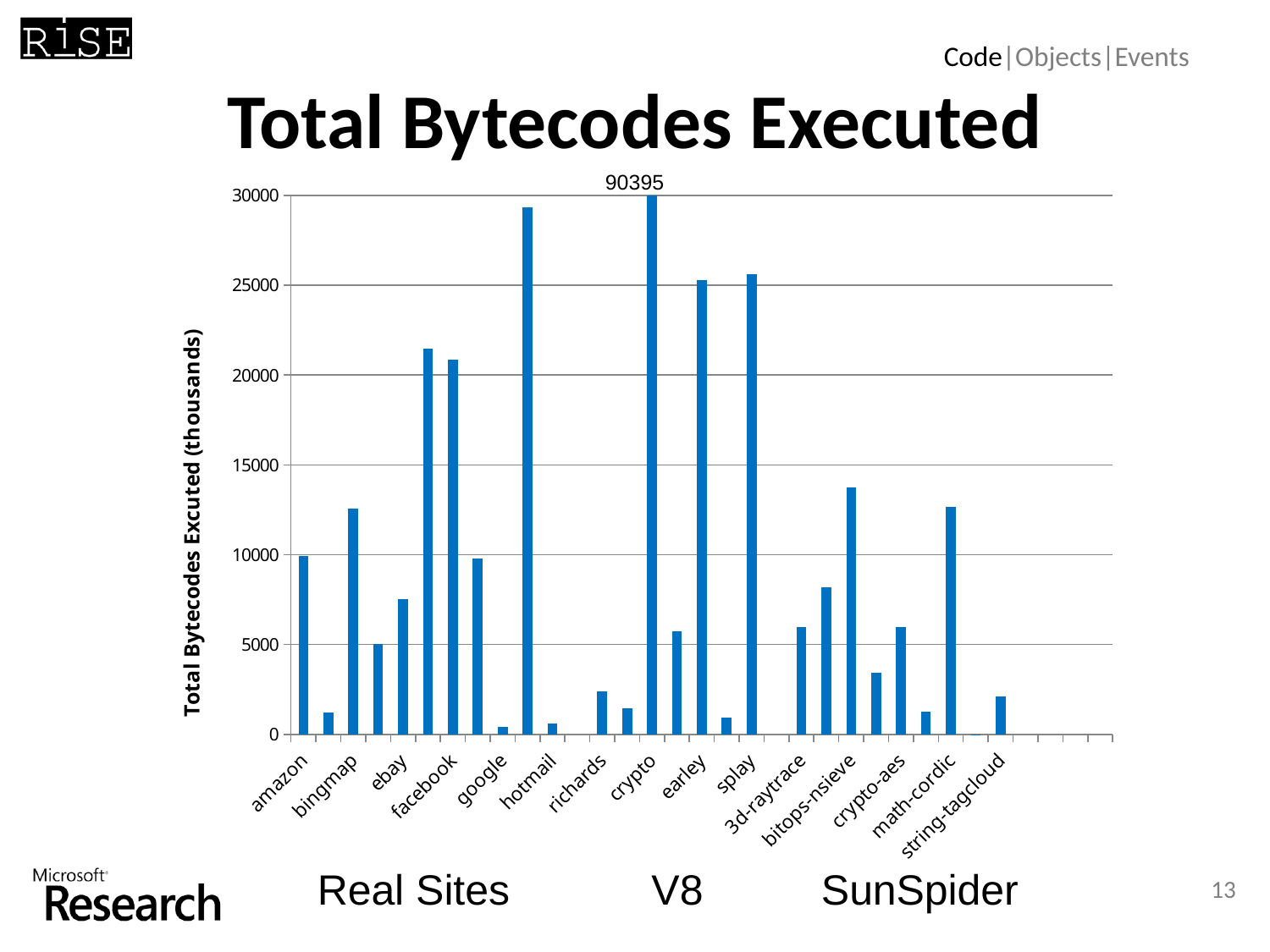
What is the value printed above the crypto bar? 90395 Is the value for amazon greater or less than 5000? greater Which is larger, the value for earley or the value for 3d-raytrace? earley Is the value for google greater or less than 5000? less Is the value for bitops-nsieve greater or less than 10000? greater What are the three benchmark groups labelled beneath the chart? Real Sites, V8, SunSpider Which is larger, the value for bingmap or the value for ebay? bingmap Which category has the highest total bytecodes executed? crypto What kind of chart is shown on the slide? bar chart What is the title of the chart? Total Bytecodes Executed